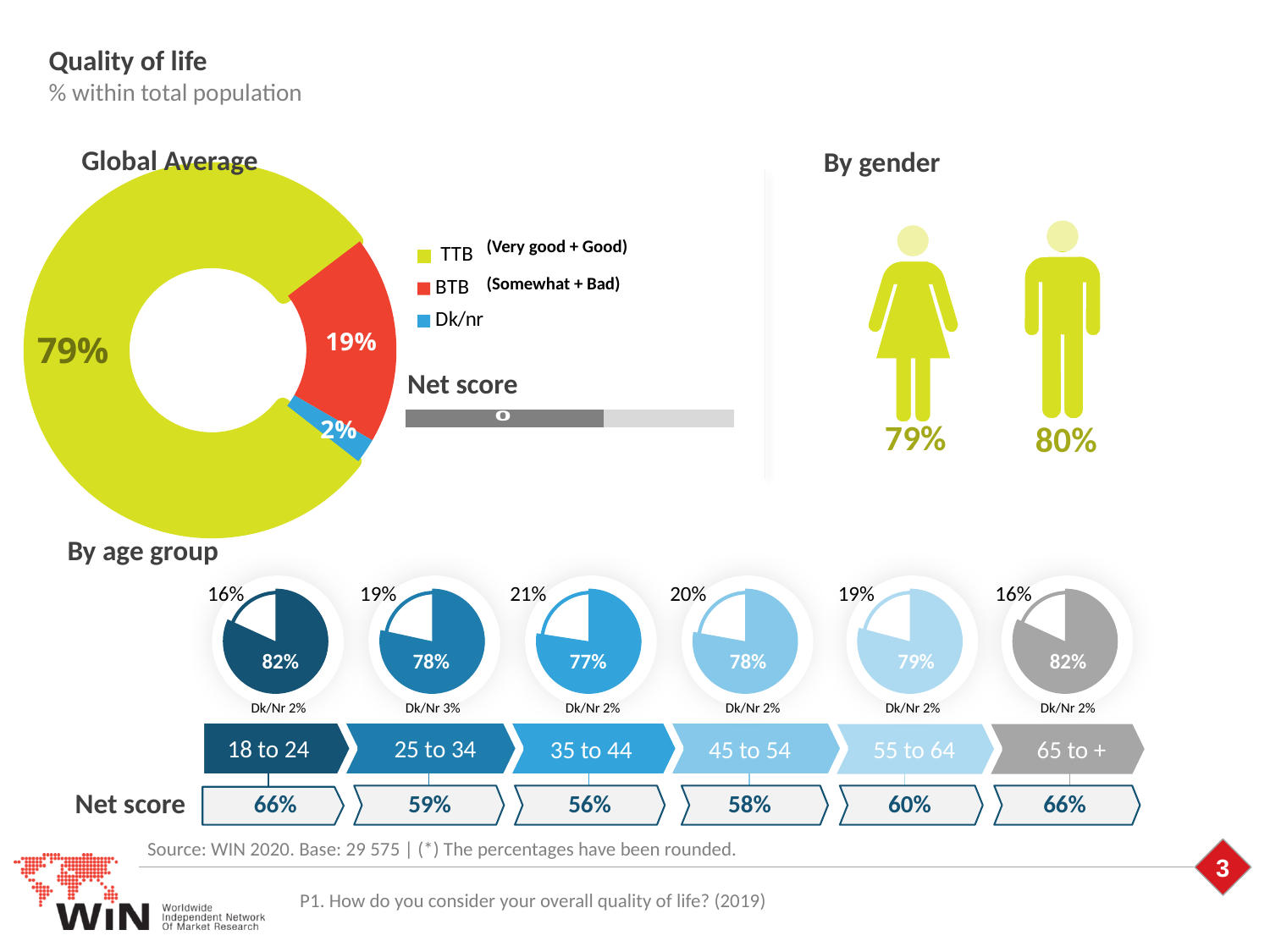
In the By age group section, how many age groups are shown? 6 On the Global Average chart, what percentage is shown for BTB? 19% What kind of chart is the Global Average chart? Donut (pie) chart In the By age group section, what is the TTB percentage for the 35 to 44 age group? 77% On the Global Average chart, what percentage is shown for Dk/nr? 2% In the By age group section, what is the Net score for the 25 to 34 age group? 59% In the By age group section, which age group has the lowest Net score? 35 to 44 On the Global Average chart, what is the difference between the TTB and BTB percentages? 60% On the Global Average chart, which category has the largest share? TTB How many entries does the legend of the Global Average chart list? 3 On the Global Average chart, what percentage is shown for TTB? 79% On the Global Average chart, which category has the smallest share? Dk/nr